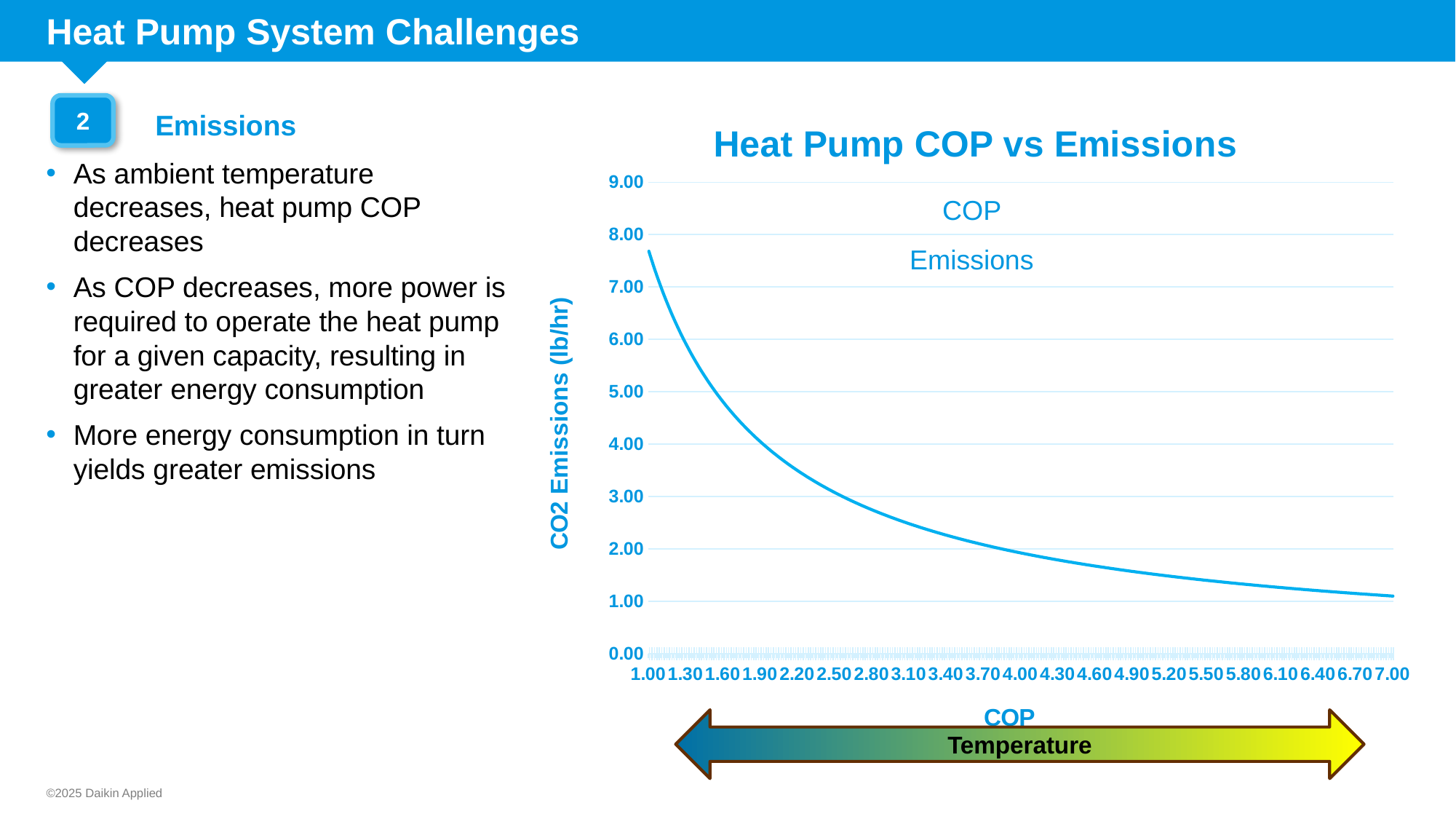
At which COP value on the x axis are emissions highest? 1.00 At which COP value on the x axis are emissions lowest? 7.00 How many COP tick labels are shown along the x axis? 21 Is the emissions value at COP 2.20 greater or less than 3.00? greater Which has higher emissions, COP 1.60 or COP 4.60? COP 1.60 Is the emissions value at COP 1.00 greater or less than 7.00? greater Is the emissions value at COP 7.00 greater or less than 2.00? less What is the title of the chart? Heat Pump COP vs Emissions Do the emissions values rise or fall as COP increases along the x axis? fall What kind of chart is shown on the slide? line chart What is the label of the vertical axis of the chart? CO2 Emissions (lb/hr)